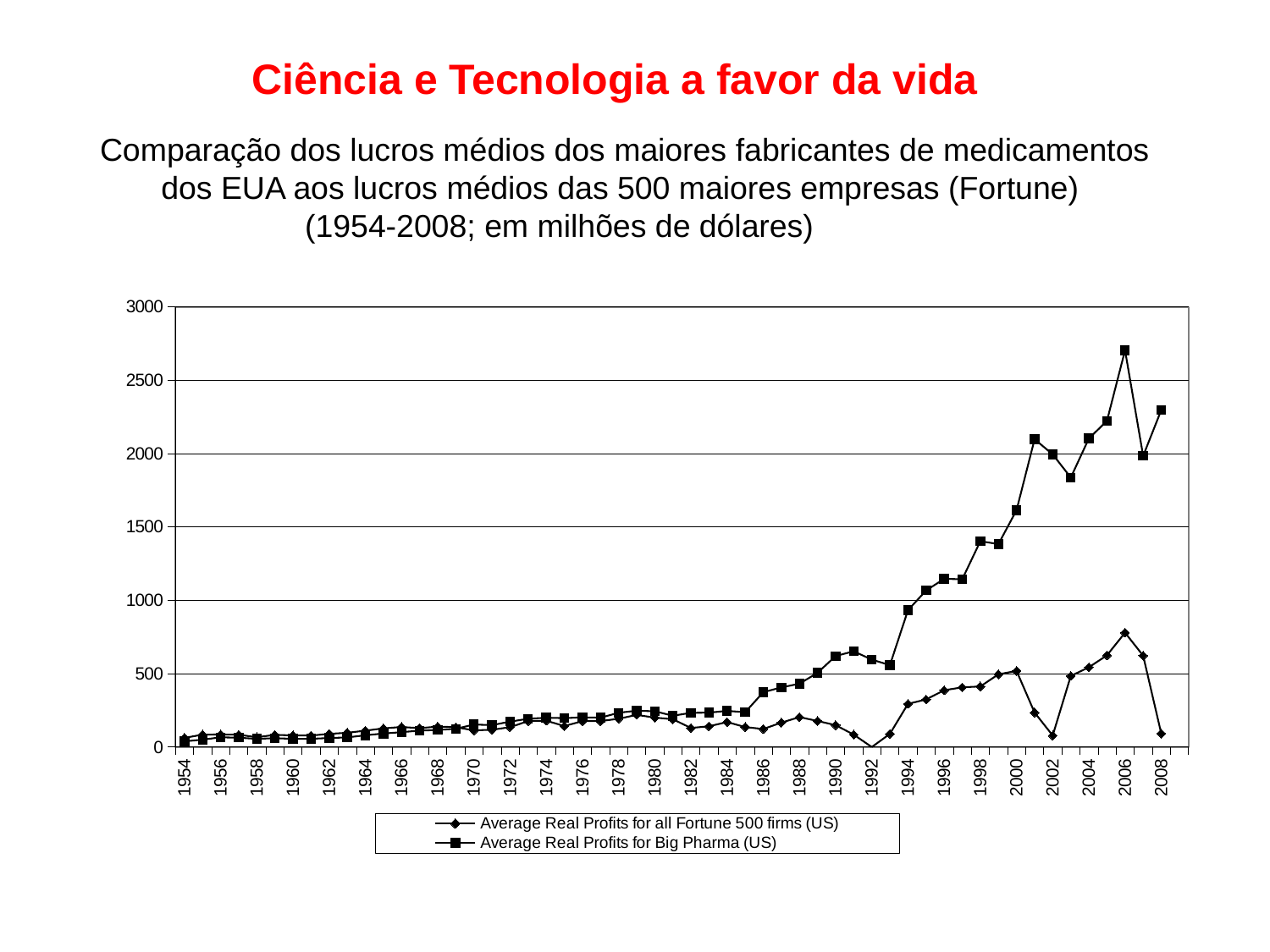
How many series does the legend list? 2 Does the Average Real Profits for Big Pharma (US) series generally rise or fall from 1954 to 2008? rise Is the value for Average Real Profits for all Fortune 500 firms (US) in 2006 greater or less than 1000? less In which year does the Average Real Profits for Big Pharma (US) series reach its highest value? 2006 Is the value for Average Real Profits for Big Pharma (US) in 2000 greater or less than 1500? greater Which series does the legend list with square markers? Average Real Profits for Big Pharma (US) In which year does the Average Real Profits for all Fortune 500 firms (US) series reach its highest value? 2006 What is the highest value shown on the vertical axis? 3000 What kind of chart is shown on the slide? line chart Is the value for Average Real Profits for Big Pharma (US) in 2006 greater or less than 2500? greater Which series has the larger value in 2008, Average Real Profits for Big Pharma (US) or Average Real Profits for all Fortune 500 firms (US)? Average Real Profits for Big Pharma (US)